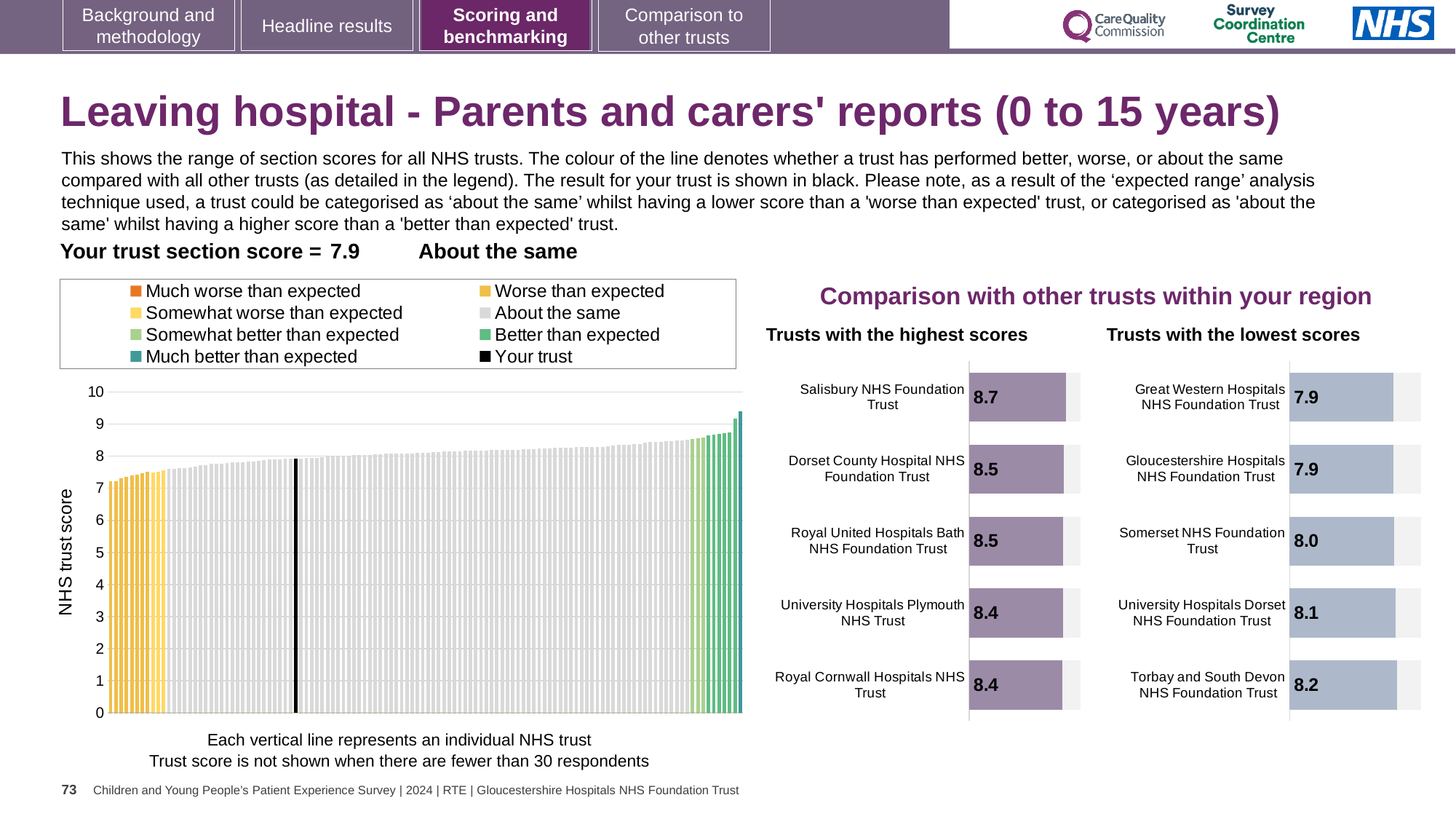
In the 'Trusts with the lowest scores' chart, what is the score for Somerset NHS Foundation Trust? 8.0 In the main 'NHS trust score' chart on the left, what is the section score for your trust (the black line)? 7.9 In the 'Trusts with the highest scores' chart, what is the difference between the scores of Salisbury NHS Foundation Trust and Royal Cornwall Hospitals NHS Trust? 0.3 In the main 'NHS trust score' chart on the left, is the value of the tallest bar greater or less than 9? greater In the 'Trusts with the lowest scores' chart, what is the difference between the scores of Torbay and South Devon NHS Foundation Trust and Great Western Hospitals NHS Foundation Trust? 0.3 In the main 'NHS trust score' chart on the left, do the trust scores rise or fall from left to right? rise How many entries does the legend of the main 'NHS trust score' chart list? 8 In the 'Trusts with the highest scores' chart, which trust has the highest score? Salisbury NHS Foundation Trust In the 'Trusts with the lowest scores' chart, which trust has the highest score? Torbay and South Devon NHS Foundation Trust In the 'Trusts with the highest scores' chart, which has the larger score: Dorset County Hospital NHS Foundation Trust or University Hospitals Plymouth NHS Trust? Dorset County Hospital NHS Foundation Trust In the 'Trusts with the highest scores' chart, what is the score for Salisbury NHS Foundation Trust? 8.7 How many trusts are listed in the 'Trusts with the lowest scores' chart? 5